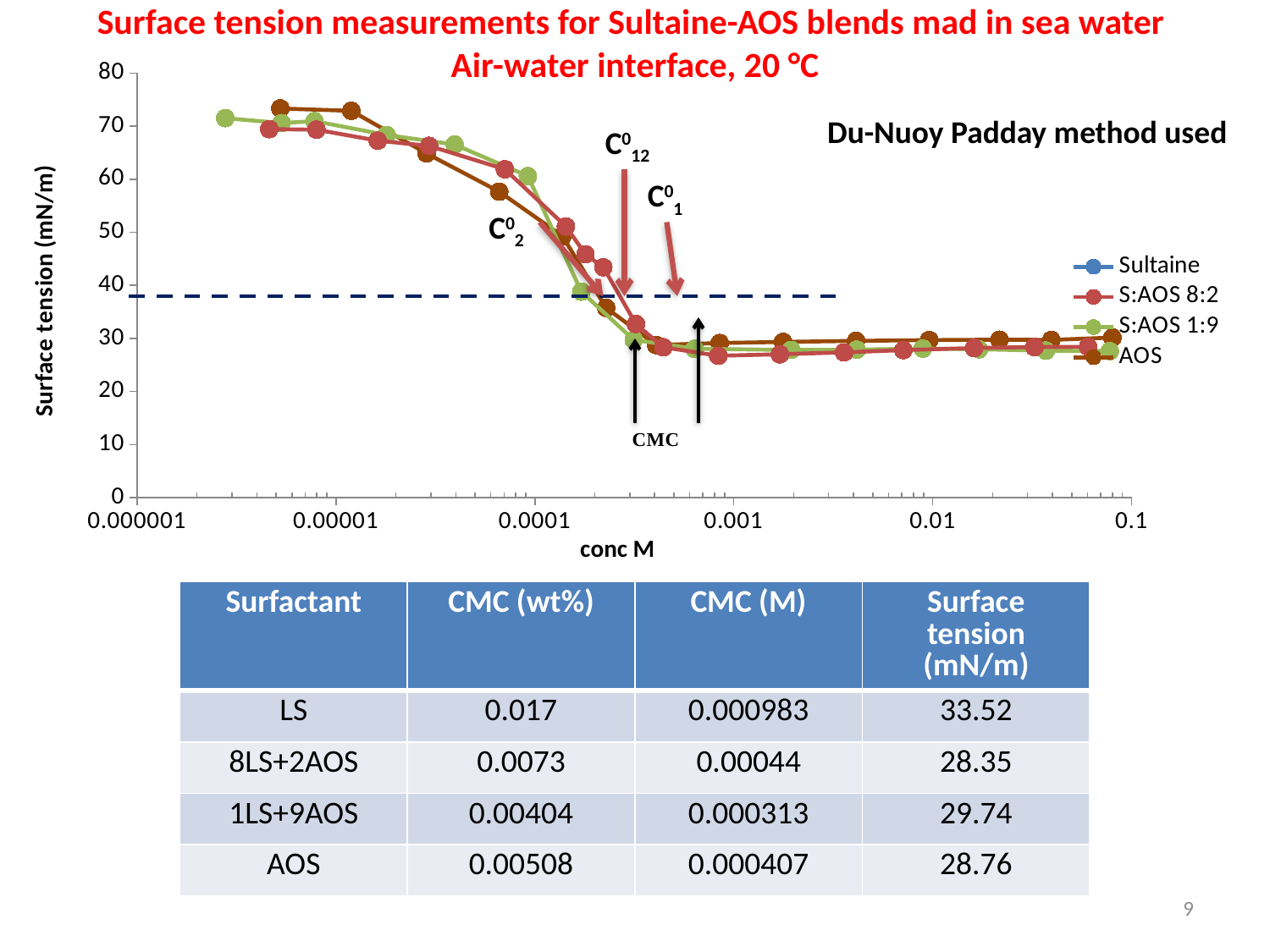
As concentration increases along the x axis, do the surface tension values rise or fall? fall What kind of chart is shown on the slide? line chart Is the surface tension for the S:AOS 1:9 series at a concentration of 0.01 M greater or less than 40 mN/m? less How many series does the chart legend list? 4 What is the label of the chart's y axis? Surface tension (mN/m) Which series are listed in the chart legend? Sultaine, S:AOS 8:2, S:AOS 1:9, AOS Is the surface tension for the S:AOS 8:2 series at a concentration of 0.0001 M greater or less than 50 mN/m? greater Is the surface tension for the S:AOS 8:2 series at a concentration of 0.001 M greater or less than 40 mN/m? less